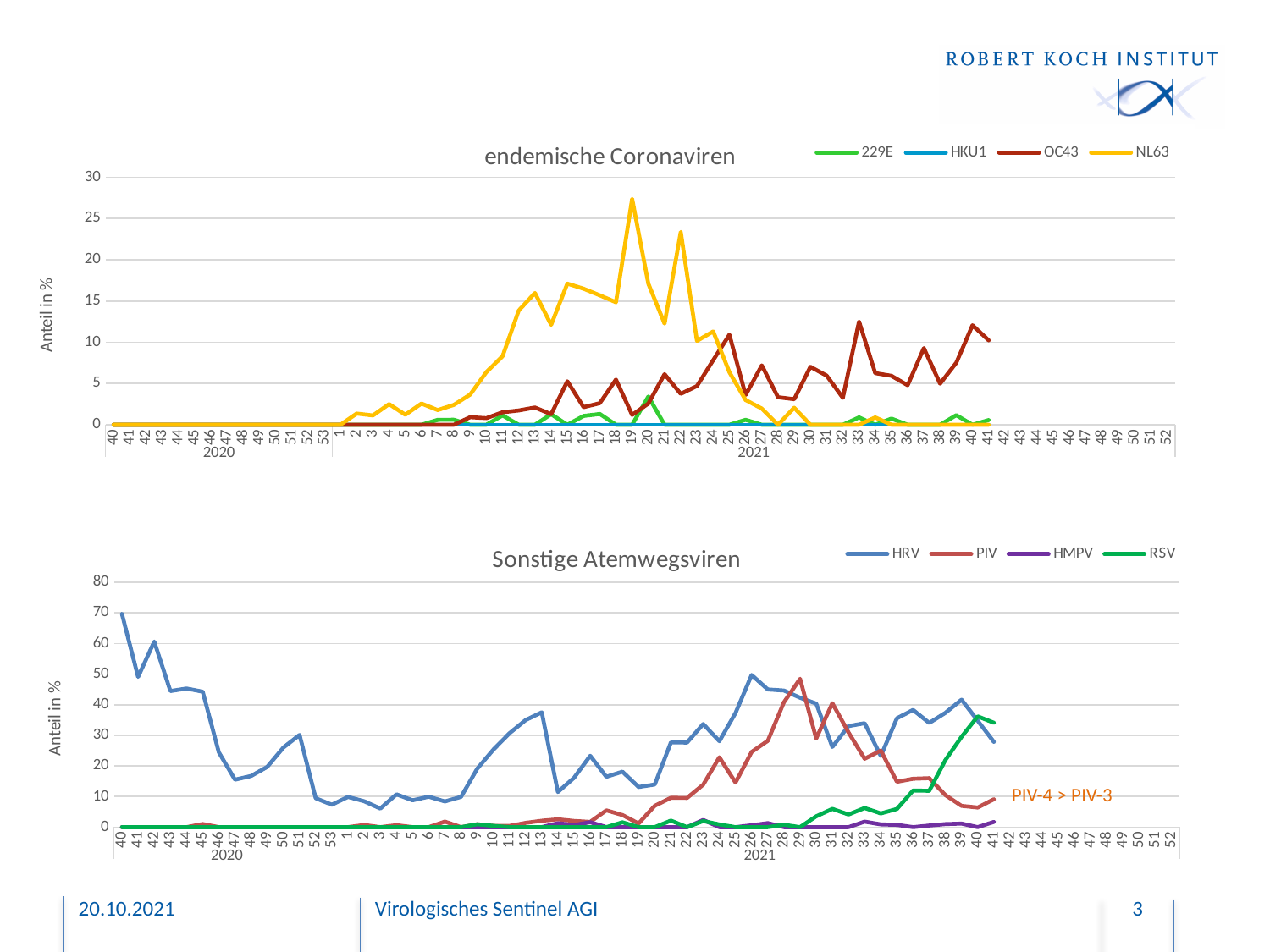
What kind of chart is the top chart titled "endemische Coronaviren"? line chart What kind of chart is the bottom chart titled "Sonstige Atemwegsviren"? line chart How many series does the legend of the bottom chart "Sonstige Atemwegsviren" list? 4 In the top chart "endemische Coronaviren", is the value of OC43 in week 33 of 2021 greater or less than 10? greater In the top chart "endemische Coronaviren", is the peak value of NL63 in week 19 of 2021 greater or less than 25? greater In the bottom chart "Sonstige Atemwegsviren", is the value of HRV in week 40 of 2020 greater or less than 60? greater In the bottom chart "Sonstige Atemwegsviren", does the RSV line rise or fall between week 33 and week 40 of 2021? rise How many series does the legend of the top chart "endemische Coronaviren" list? 4 In the top chart "endemische Coronaviren", which series reaches the highest value on the chart? NL63 In the bottom chart "Sonstige Atemwegsviren", which is larger in week 41 of 2021, RSV or PIV? RSV What is the label of the vertical axis on the top chart "endemische Coronaviren"? Anteil in % In the bottom chart "Sonstige Atemwegsviren", which series has the highest value in week 40 of 2020? HRV